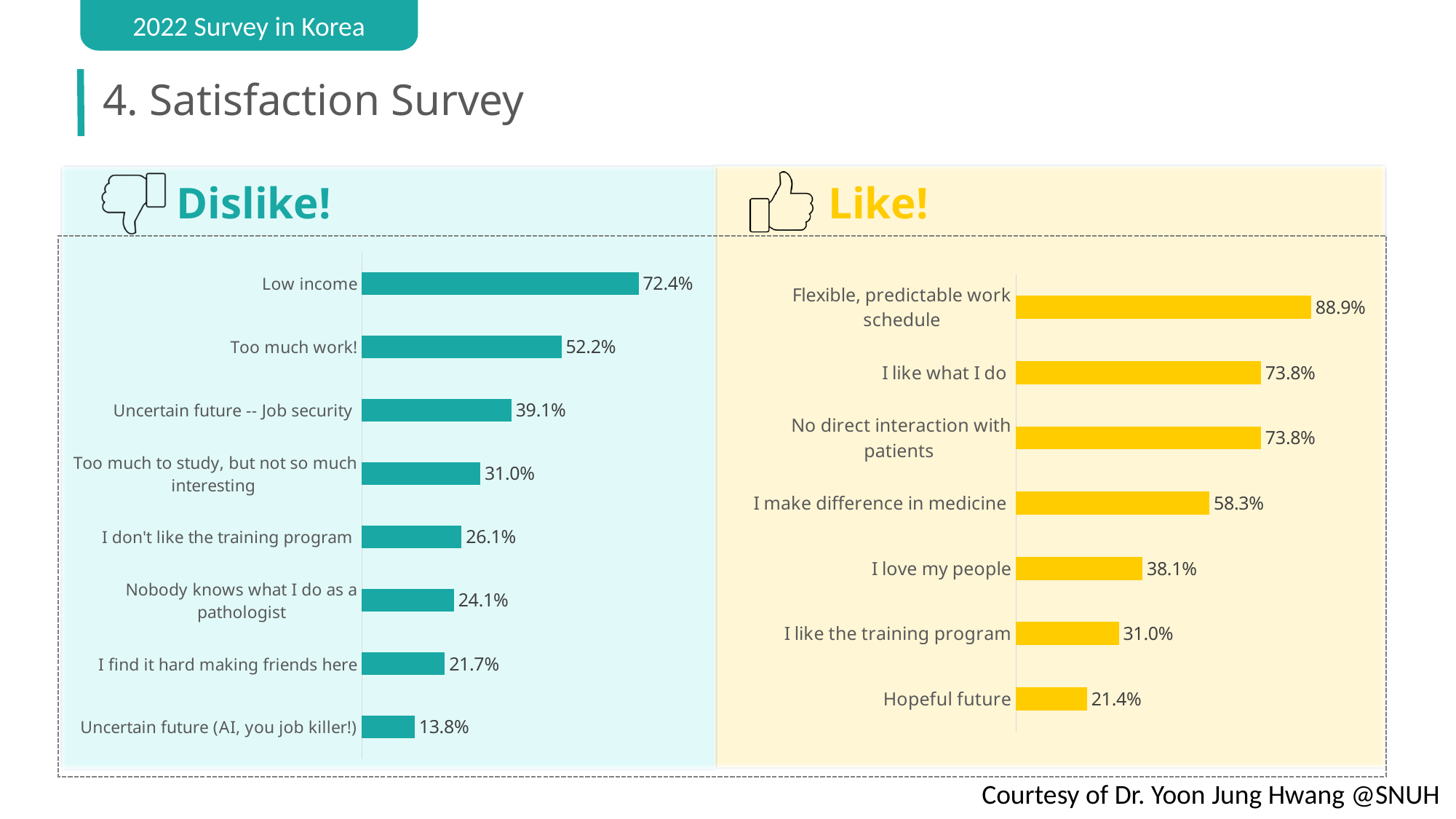
In the Dislike! chart, which is larger: Uncertain future -- Job security or I don't like the training program? Uncertain future -- Job security In the Dislike! chart, what is the value for Low income? 72.4% What colour are the bars in the Dislike! chart? Teal In the Dislike! chart, which category has the lowest value? Uncertain future (AI, you job killer!) In the Like! chart, which category has the highest value? Flexible, predictable work schedule How many categories does the Like! chart show? 7 In the Like! chart, what is the value for I like the training program? 31.0% In the Dislike! chart, what is the difference between Low income and Too much work!? 20.2% How many categories does the Dislike! chart show? 8 What kind of chart is the Like! chart? Bar chart In the Like! chart, what is the value for I make difference in medicine? 58.3% In the Like! chart, what is the difference between I love my people and Hopeful future? 16.7%